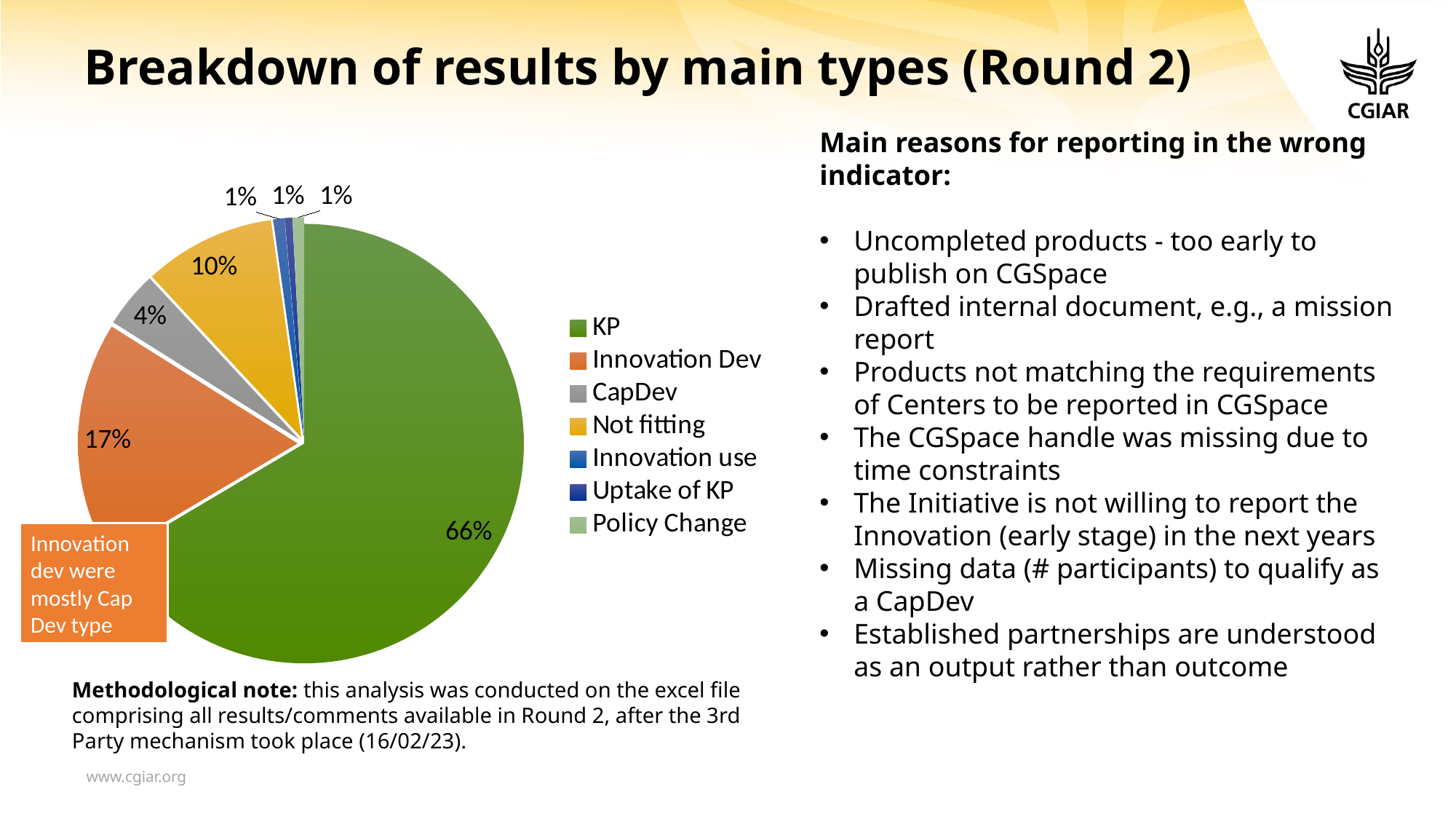
What is the difference in percentage points between KP and Innovation Dev? 49 percentage points What percentage of results is labelled Not fitting? 10% What percentage of results is Policy Change? 1% What share of results is KP in the pie chart? 66% Which is larger, the share for Not fitting or the share for CapDev? Not fitting What type of chart is shown on the slide? Pie chart Which category has the largest share of the pie? KP What percentage of results is Innovation Dev? 17% How many categories does the pie chart show? 7 What percentage of results is CapDev? 4% What colour is the KP slice in the pie chart? Green How many entries does the legend list? 7